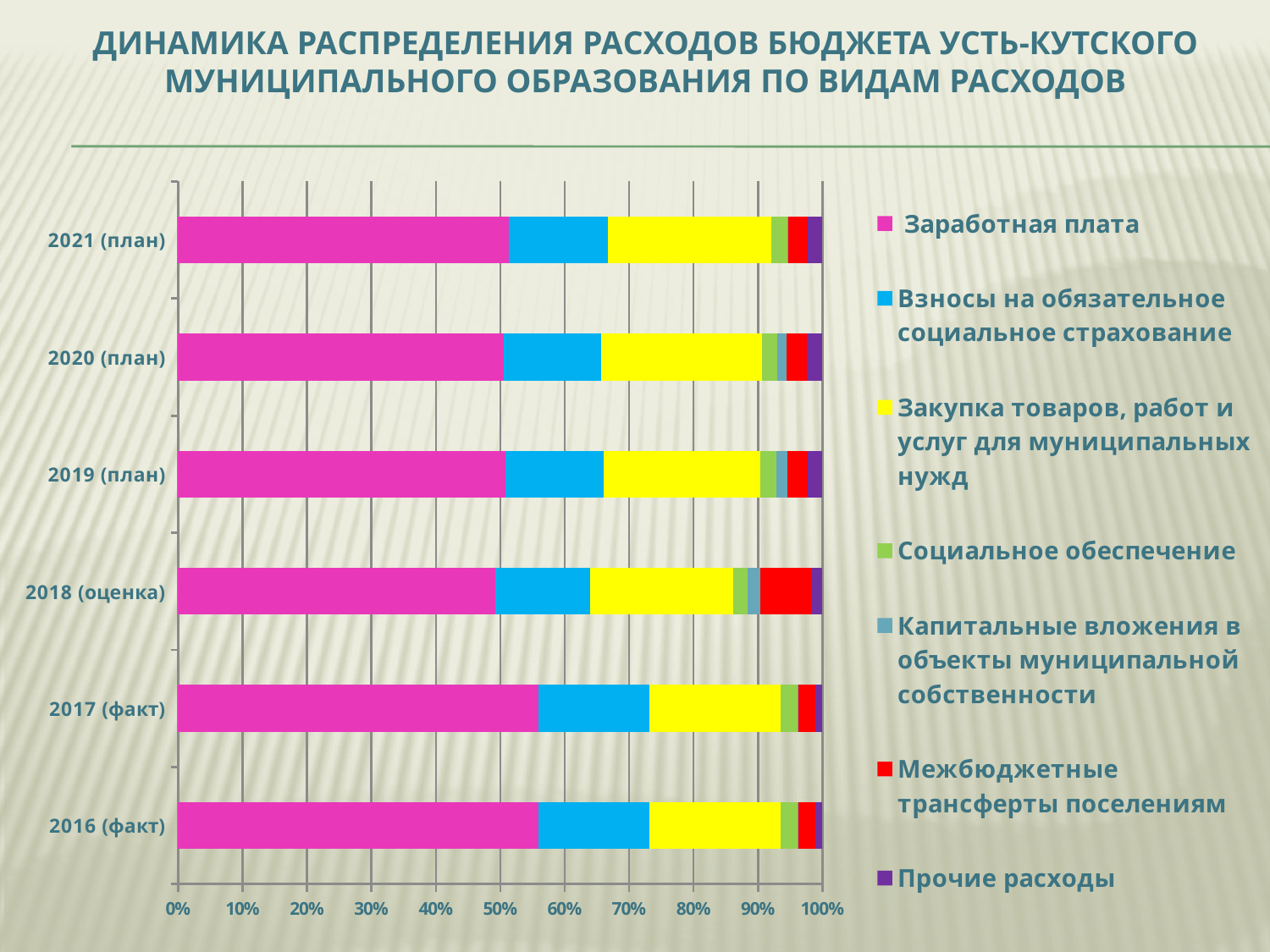
What is the highest value shown on the horizontal axis? 100% What kind of chart is shown on the slide? Stacked bar chart Which category has the largest Межбюджетные трансферты поселениям segment? 2018 (оценка) How many series does the legend list? 7 Which series is shown in magenta (pink) in the legend? Заработная плата Which category is listed at the top of the chart? 2021 (план) Which is larger: the Заработная плата share for 2017 (факт) or for 2018 (оценка)? 2017 (факт) Is the share of Заработная плата for 2016 (факт) greater or less than 40%? greater How many categories (years) are plotted on the chart? 6 Is the share of Заработная плата for 2021 (план) greater or less than 60%? less Is the share of Заработная плата for 2017 (факт) greater or less than 50%? greater